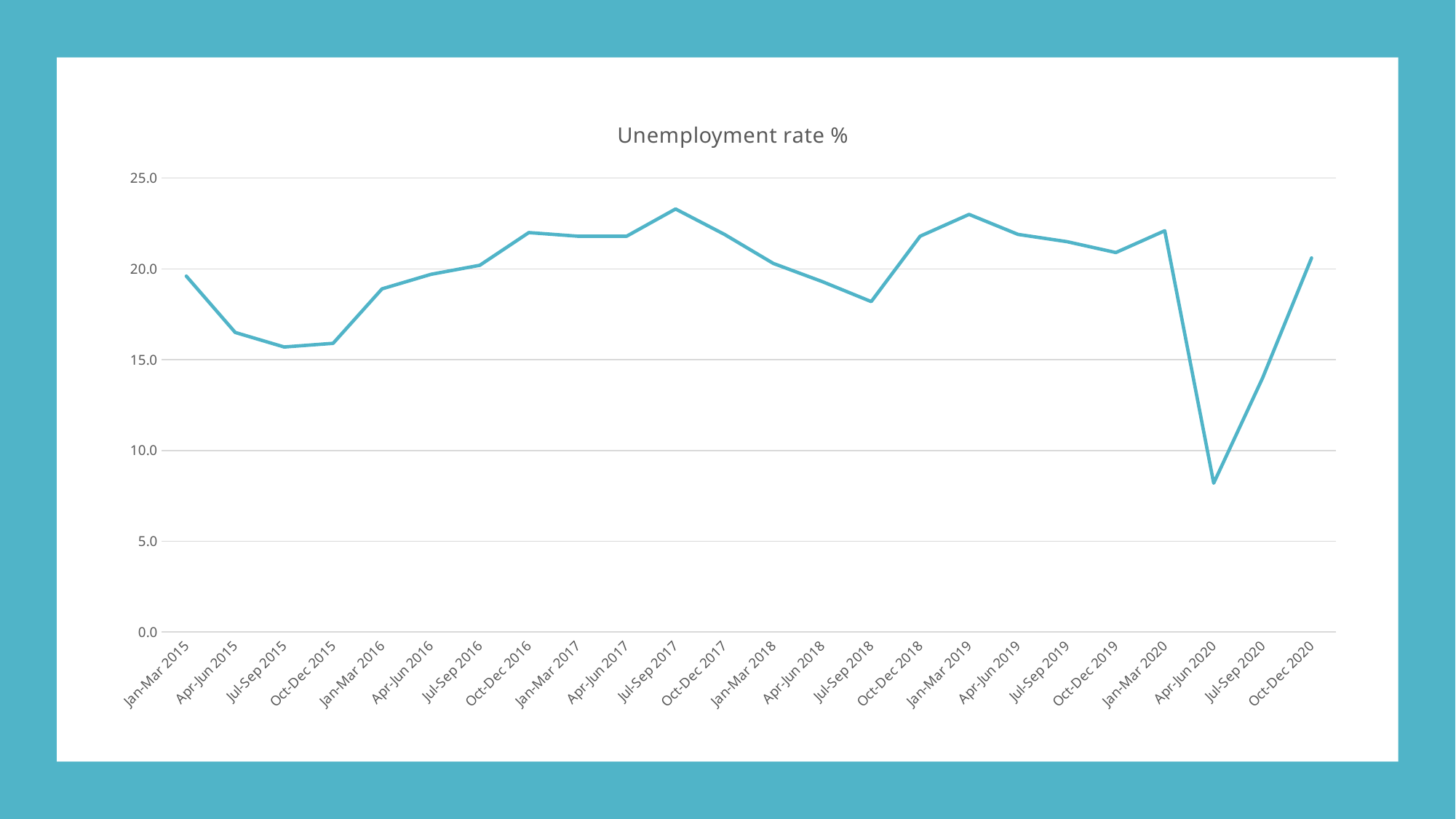
Which quarter has the lowest unemployment rate? Apr-Jun 2020 Is the value for Apr-Jun 2020 greater or less than 10.0? less How many quarterly data points are plotted on the chart? 24 What is the title of the chart? Unemployment rate % Is the value for Oct-Dec 2016 greater or less than 20.0? greater Is the value for Jan-Mar 2015 greater or less than 20.0? less Does the unemployment rate rise or fall from Jan-Mar 2015 to Jul-Sep 2015? fall What kind of chart is shown on the slide? line chart Which is larger, the value for Jul-Sep 2015 or the value for Jan-Mar 2016? Jan-Mar 2016 Does the unemployment rate rise or fall from Apr-Jun 2020 to Oct-Dec 2020? rise